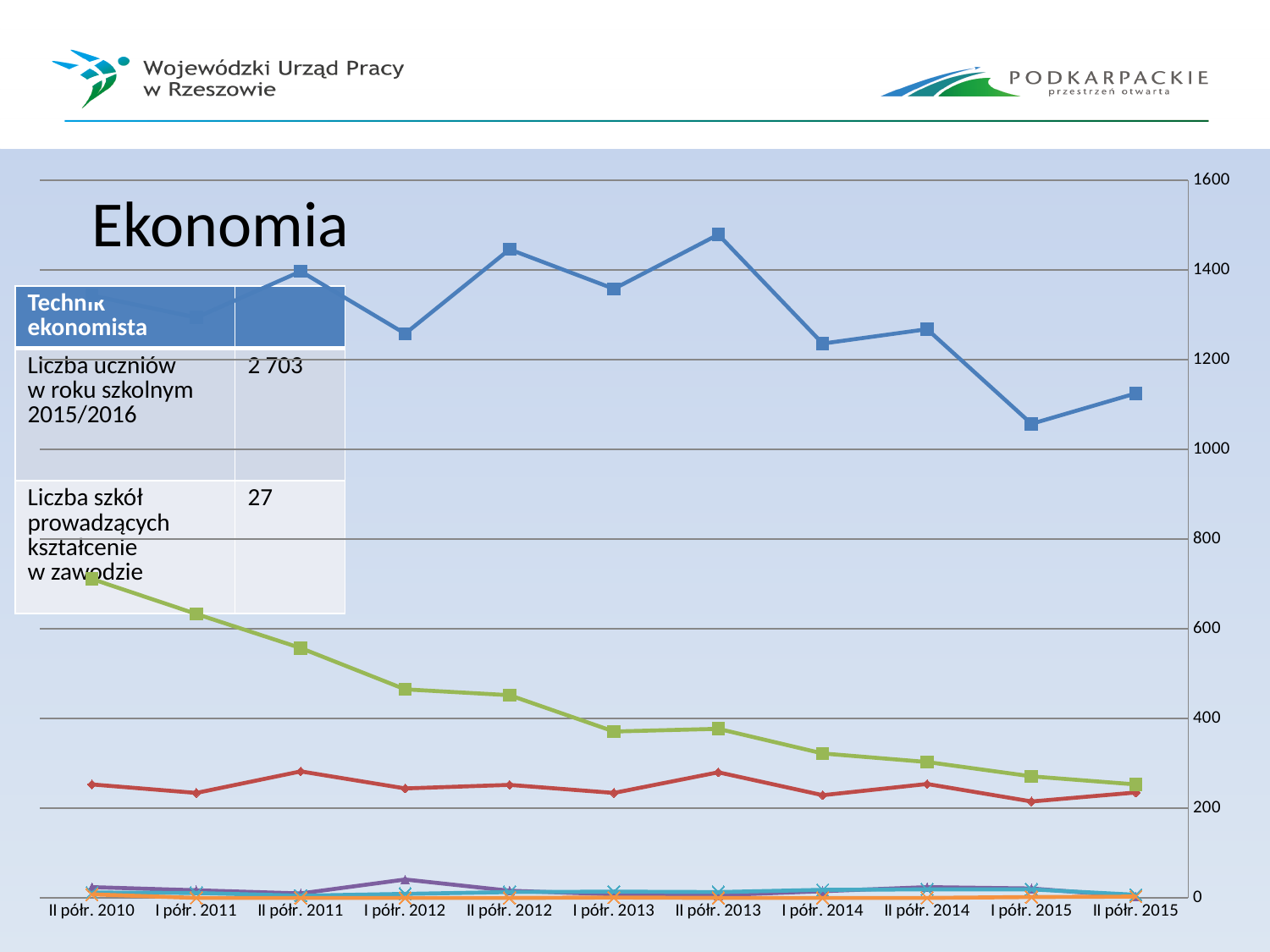
What kind of chart is shown on the slide? line chart In which period does the green line reach its highest value? II półr. 2010 Which line has the larger value in II półr. 2010, the blue line or the green line? the blue line Is the value of the green line for II półr. 2010 greater or less than 600? greater Does the green line rise or fall from II półr. 2010 to II półr. 2015? fall Is the value of the green line for II półr. 2015 greater or less than 400? less How many time periods are shown on the x axis of the chart? 11 Is the value of the blue line for II półr. 2013 greater or less than 1400? greater What is the highest value shown on the vertical axis of the chart? 1600 What is the title shown on the chart? Ekonomia In which period does the blue line reach its lowest value? I półr. 2015